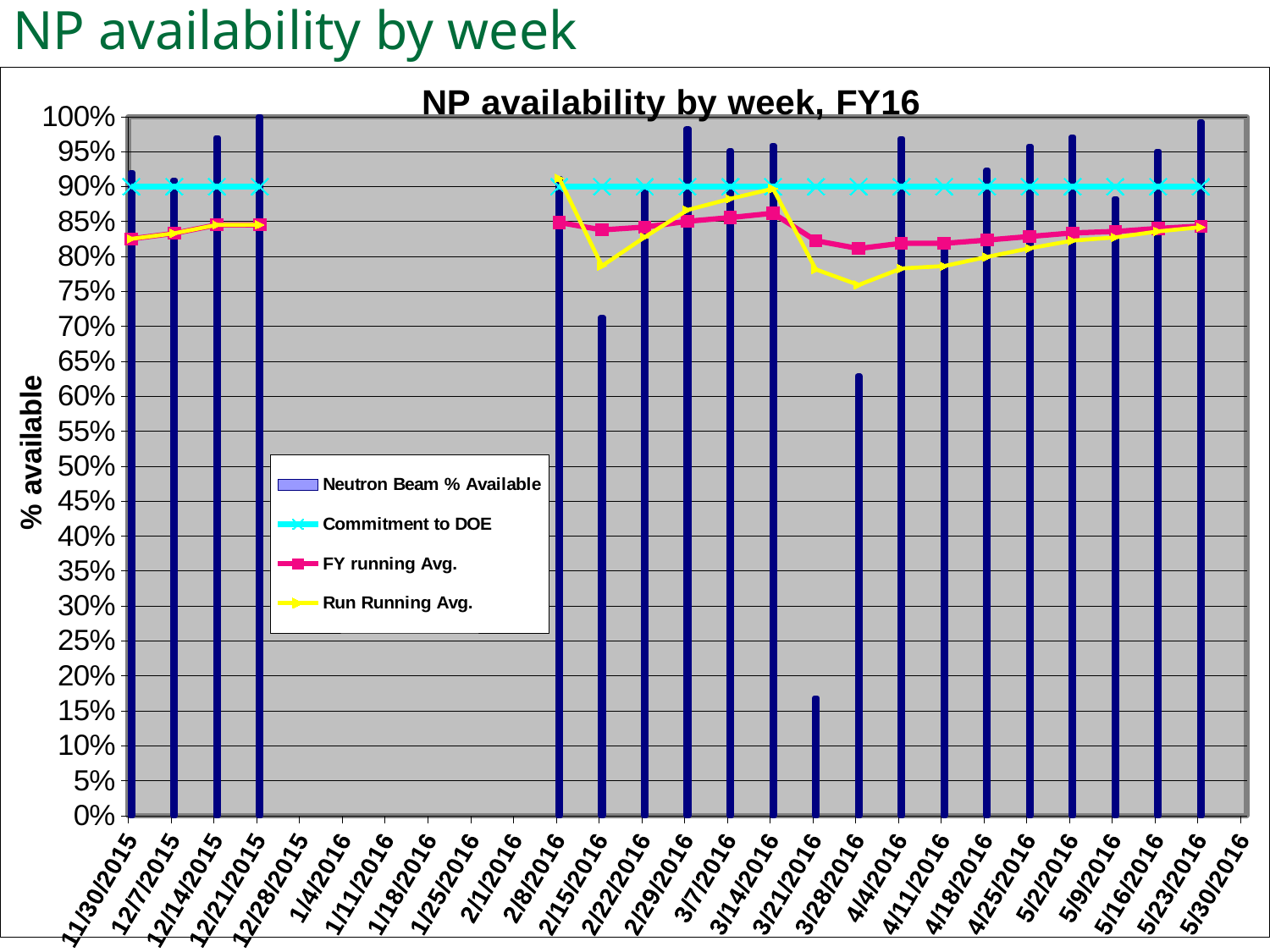
Is the Neutron Beam % Available value for 3/28/2016 greater or less than 70%? less Which week has the lowest Neutron Beam % Available bar? 3/21/2016 What value does the Commitment to DOE line sit at? 90% What kind of chart is shown on the slide? bar and line chart Which series is drawn as the yellow line? Run Running Avg. Which week has the larger Neutron Beam % Available bar, 2/15/2016 or 3/28/2016? 2/15/2016 Is the Neutron Beam % Available value for 3/21/2016 greater or less than 20%? less Which week has the highest Neutron Beam % Available bar? 12/21/2015 At 3/28/2016, which is larger, the FY running Avg. or the Run Running Avg.? FY running Avg. How many date labels are shown on the x axis? 27 How many series does the legend list? 4 Is the Run Running Avg. value at 3/28/2016 greater or less than 80%? less